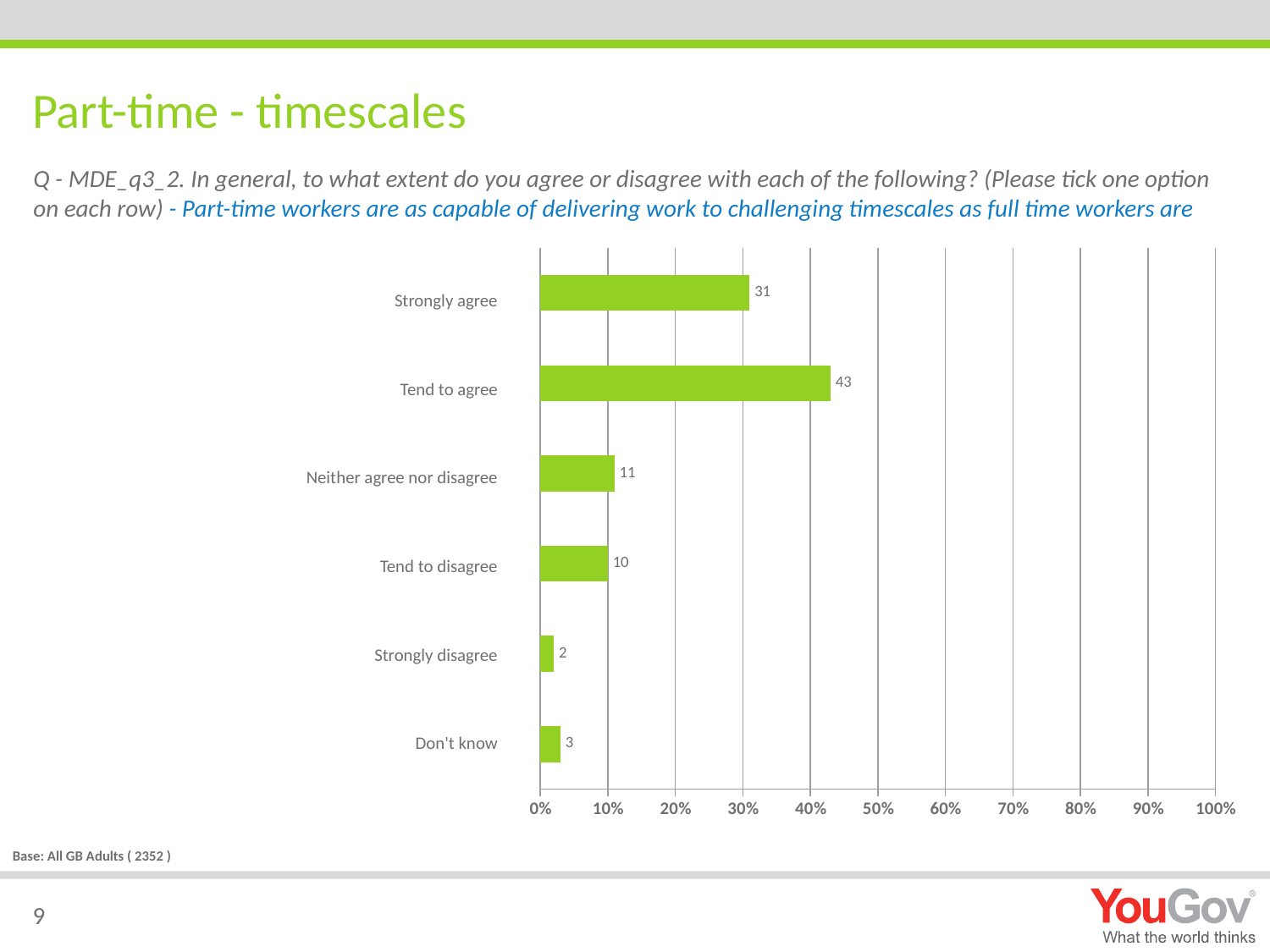
What is the value for "Tend to agree"? 43 What is the value for "Don't know"? 3 Which is larger, the value for "Neither agree nor disagree" or the value for "Tend to disagree"? Neither agree nor disagree What is the base stated below the chart? All GB Adults ( 2352 ) What is the value for "Strongly agree"? 31 What kind of chart is shown on the slide? Bar chart How many categories are shown in the chart? 6 Is the value for "Tend to agree" greater or less than 40%? greater What is the difference between the values for "Tend to agree" and "Strongly agree"? 12 What is the value for "Neither agree nor disagree"? 11 Which category has the highest value? Tend to agree Which category has the lowest value? Strongly disagree